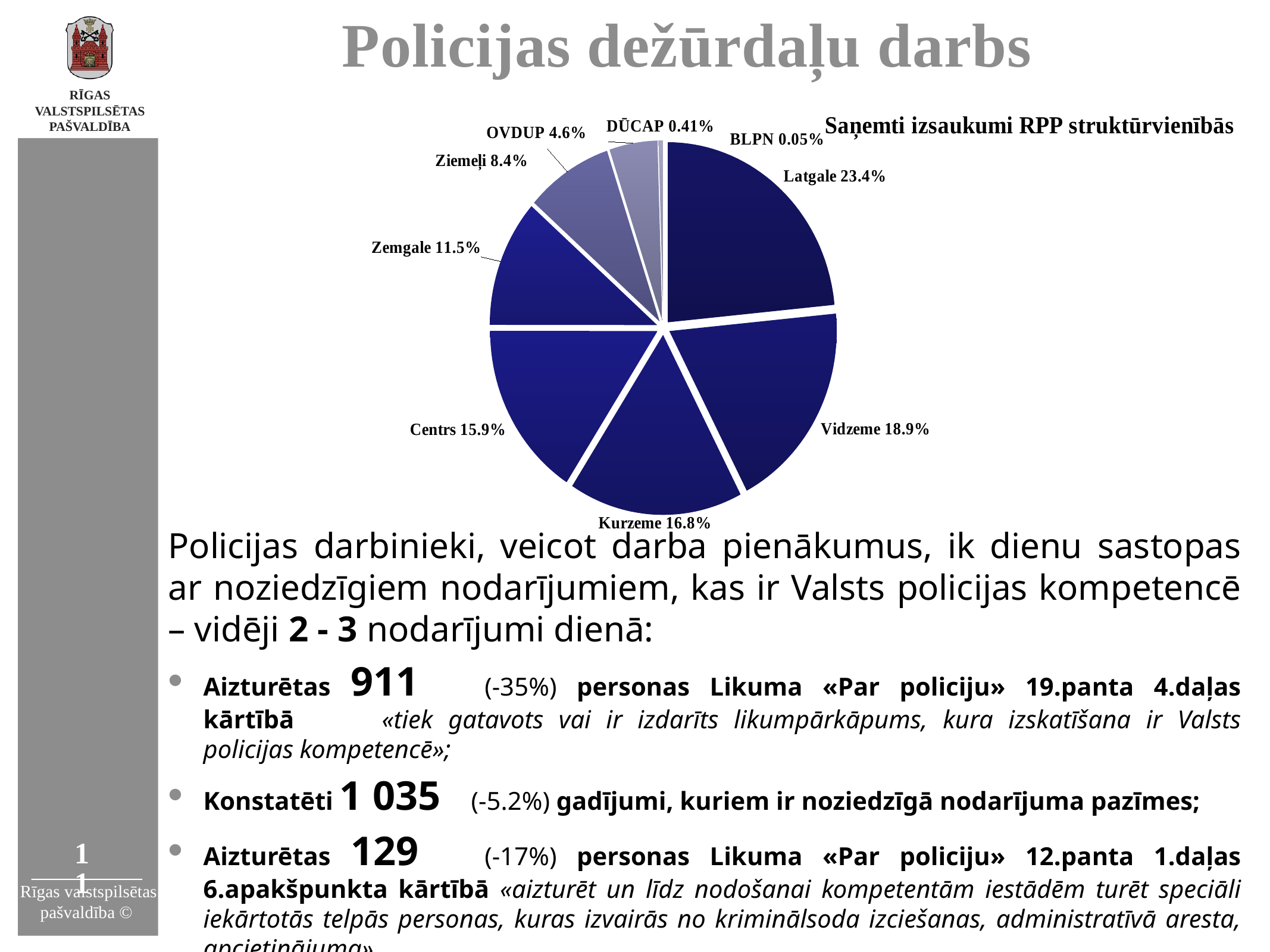
What share of the pie does Latgale have? 23.4% What is the value shown for Vidzeme? 18.9% What kind of chart is shown on the slide? pie chart What is the difference between the shares for Latgale and Vidzeme? 4.5% Which slice of the pie is the smallest? BLPN Which slice of the pie is the largest? Latgale Which is larger, the share for Centrs or the share for Zemgale? Centrs What is the value shown for DŪCAP? 0.41% What is the title of the pie chart? Saņemti izsaukumi RPP struktūrvienībās What is the difference between the shares for Ziemeļi and OVDUP? 3.8% What is the value shown for Kurzeme? 16.8% How many slices does the pie chart have? 9